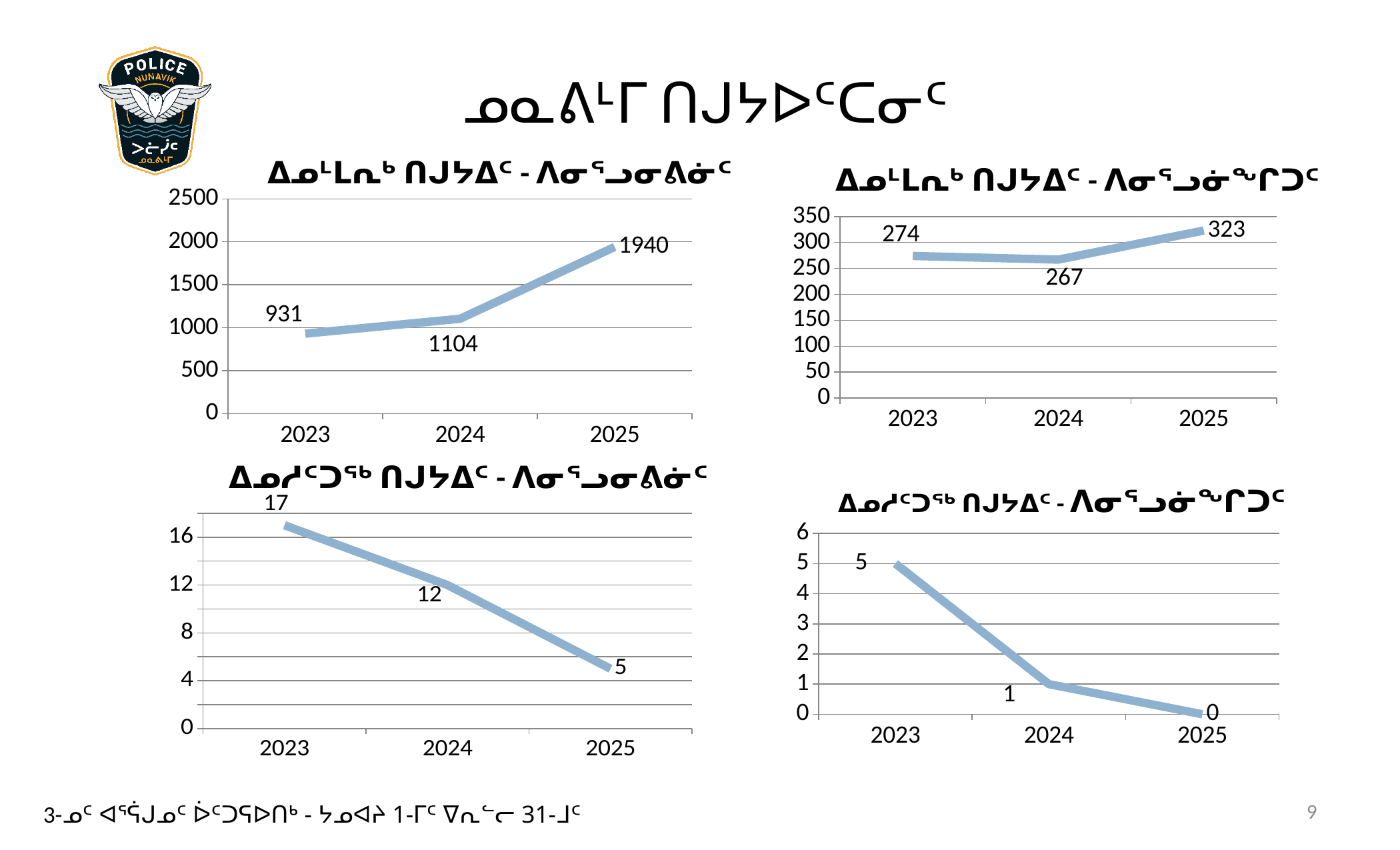
In the bottom-right chart, which is larger, the value for 2023 or the value for 2024? 2023 In the top-right chart, what is the difference between the 2023 and 2024 values? 7 In the bottom-left chart, which year has the highest value? 2023 What kind of chart is the top-left chart? line chart In the bottom-left chart, what is the value for 2024? 12 In the top-left chart, what is the difference between the 2025 and 2024 values? 836 In the top-right chart, which year has the lowest value? 2024 In the bottom-left chart, do the values rise or fall from 2023 to 2025? fall In the top-left chart, what is the value for 2023? 931 In the bottom-right chart, what is the value for 2025? 0 In the top-left chart, what is the value for 2025? 1940 In the top-right chart, what is the value for 2025? 323